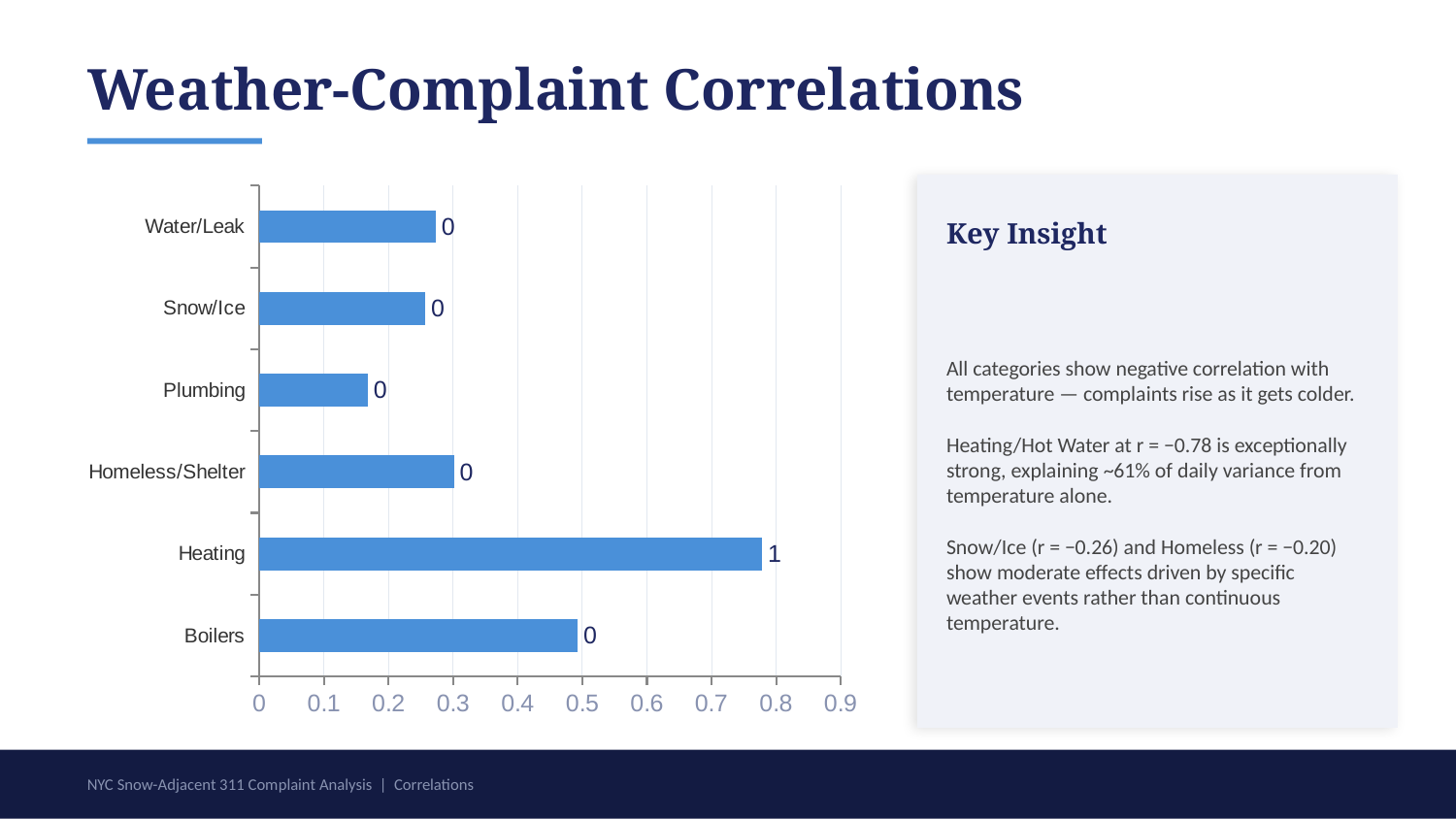
Is the value for Boilers greater or less than 0.4? greater Is the value for Homeless/Shelter greater or less than 0.2? greater Is the value for Heating greater or less than 0.7? greater Which category has the shortest bar in the chart? Plumbing Which has the larger value, Boilers or Homeless/Shelter? Boilers What data label is printed next to the Heating bar? 1 What kind of chart is shown on the slide? bar chart Which has the larger value, Heating or Boilers? Heating What is the highest tick value shown on the horizontal axis of the chart? 0.9 How many categories are plotted in the chart? 6 Which category has the longest bar in the chart? Heating